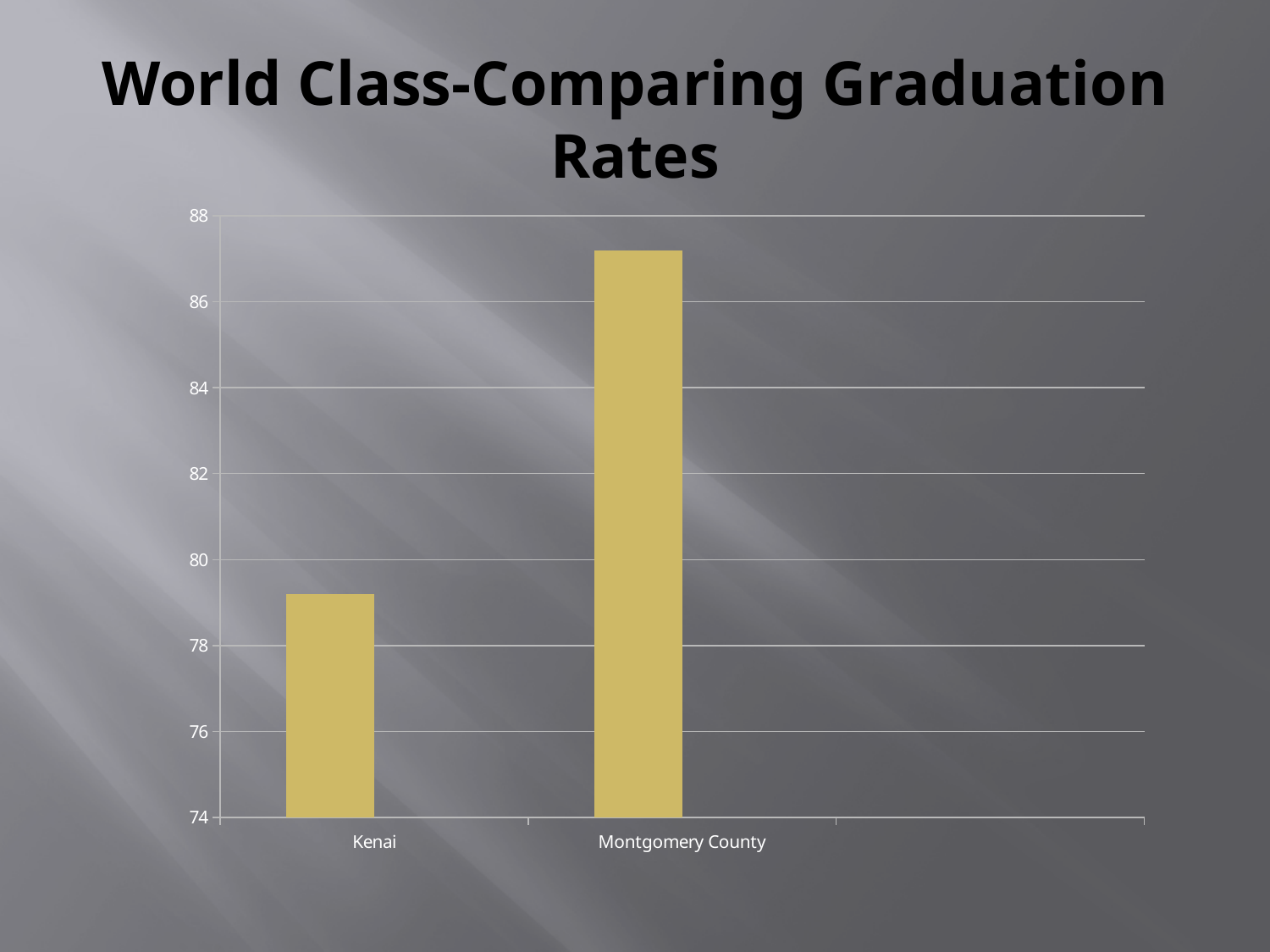
How many categories are plotted in the chart? 2 Is the value for Kenai greater or less than 78? greater Is the value for Montgomery County greater or less than 86? greater Which category has the lowest graduation rate? Kenai Do the values rise or fall moving from Kenai to Montgomery County along the x axis? rise What is the lowest value shown on the vertical axis? 74 Is the value for Kenai greater or less than 80? less Which is larger, the value for Kenai or the value for Montgomery County? Montgomery County What kind of chart is shown on the slide? bar chart Which category has the highest graduation rate? Montgomery County What is the title of the slide containing the chart? World Class-Comparing Graduation Rates